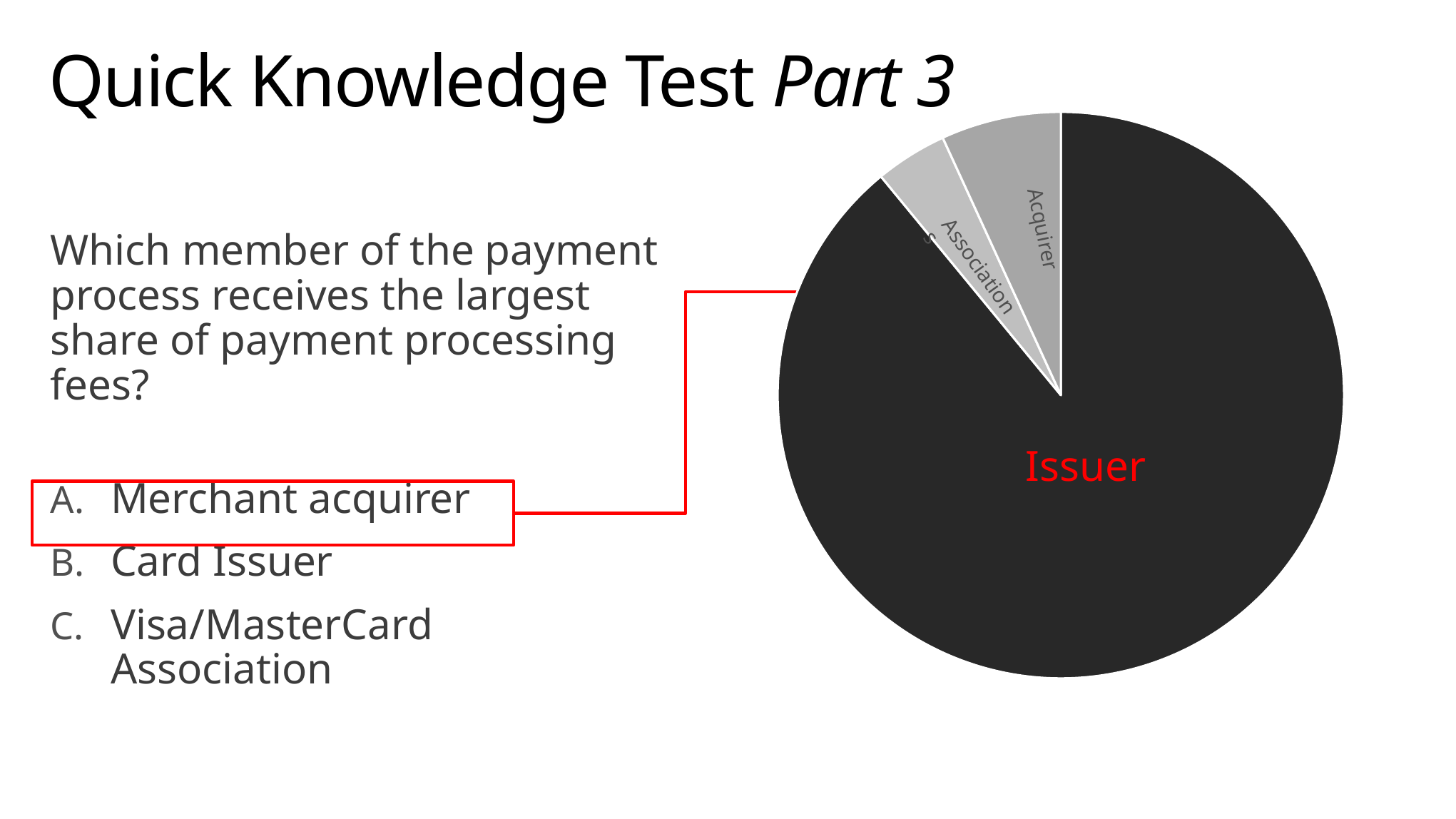
Which slice is larger in the pie chart, Acquirer or Association? Acquirer What colour is the Issuer slice of the pie chart? dark grey/black What kind of chart is shown on the slide? pie chart Which slice is larger in the pie chart, Issuer or Acquirer? Issuer What colour is the text of the Issuer label on the pie chart? red Which slice of the pie chart is the largest? Issuer How many slices does the pie chart have? 3 Which slice is larger in the pie chart, Association or Issuer? Issuer